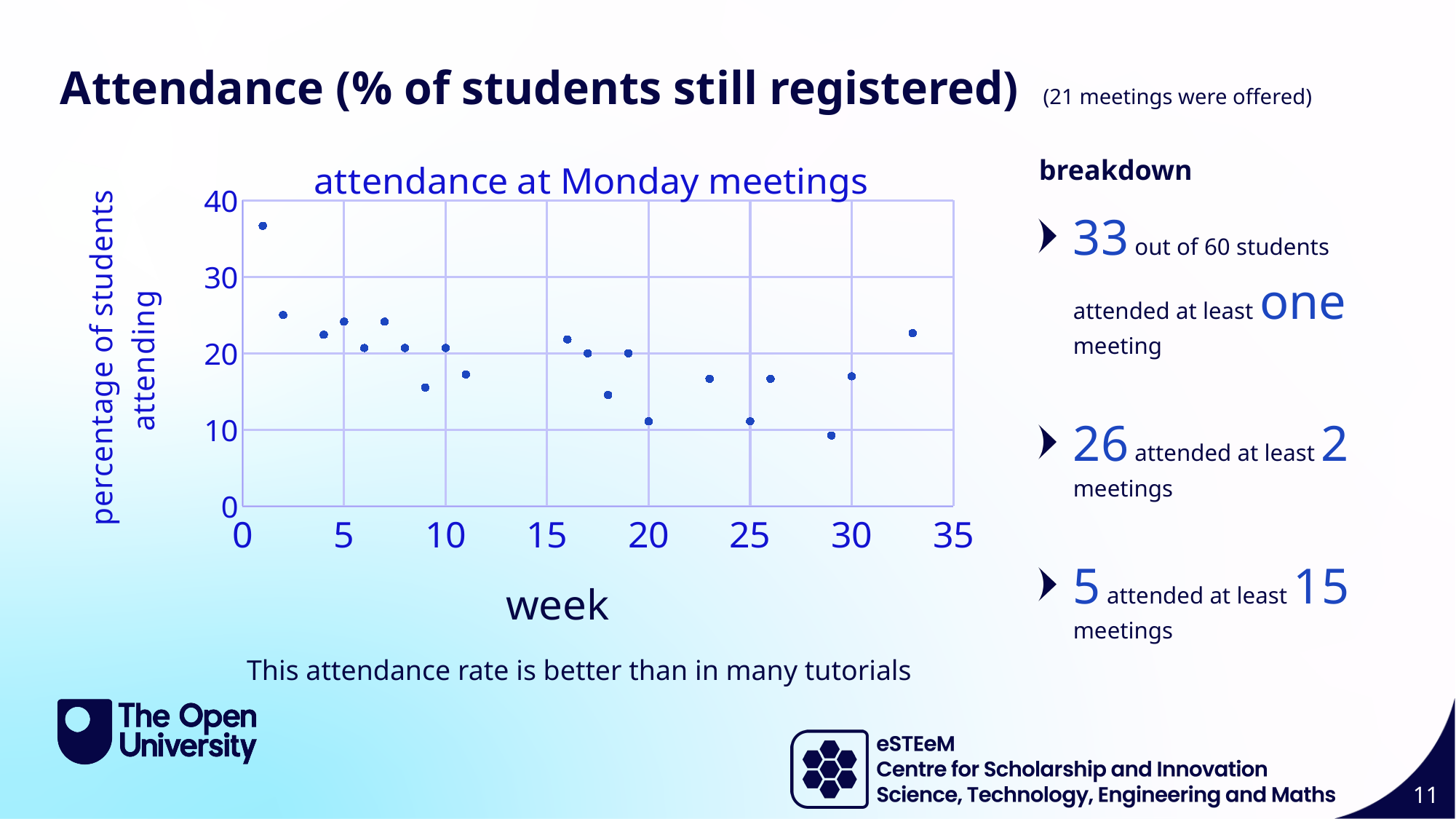
Is the attendance percentage for week 2 greater or less than 20? greater Overall, does the attendance percentage tend to rise or fall as the weeks progress? fall What is the title of the chart? attendance at Monday meetings What kind of chart is shown on the slide? scatter chart Is the attendance percentage for week 9 greater or less than 20? less Is the attendance percentage for week 29 greater or less than 10? less Which week has the higher attendance percentage, week 33 or week 25? week 33 Which week has the higher attendance percentage, week 1 or week 20? week 1 What is the label of the x axis of the chart? week In which week is the attendance percentage highest? week 1 In which week is the attendance percentage lowest? week 29